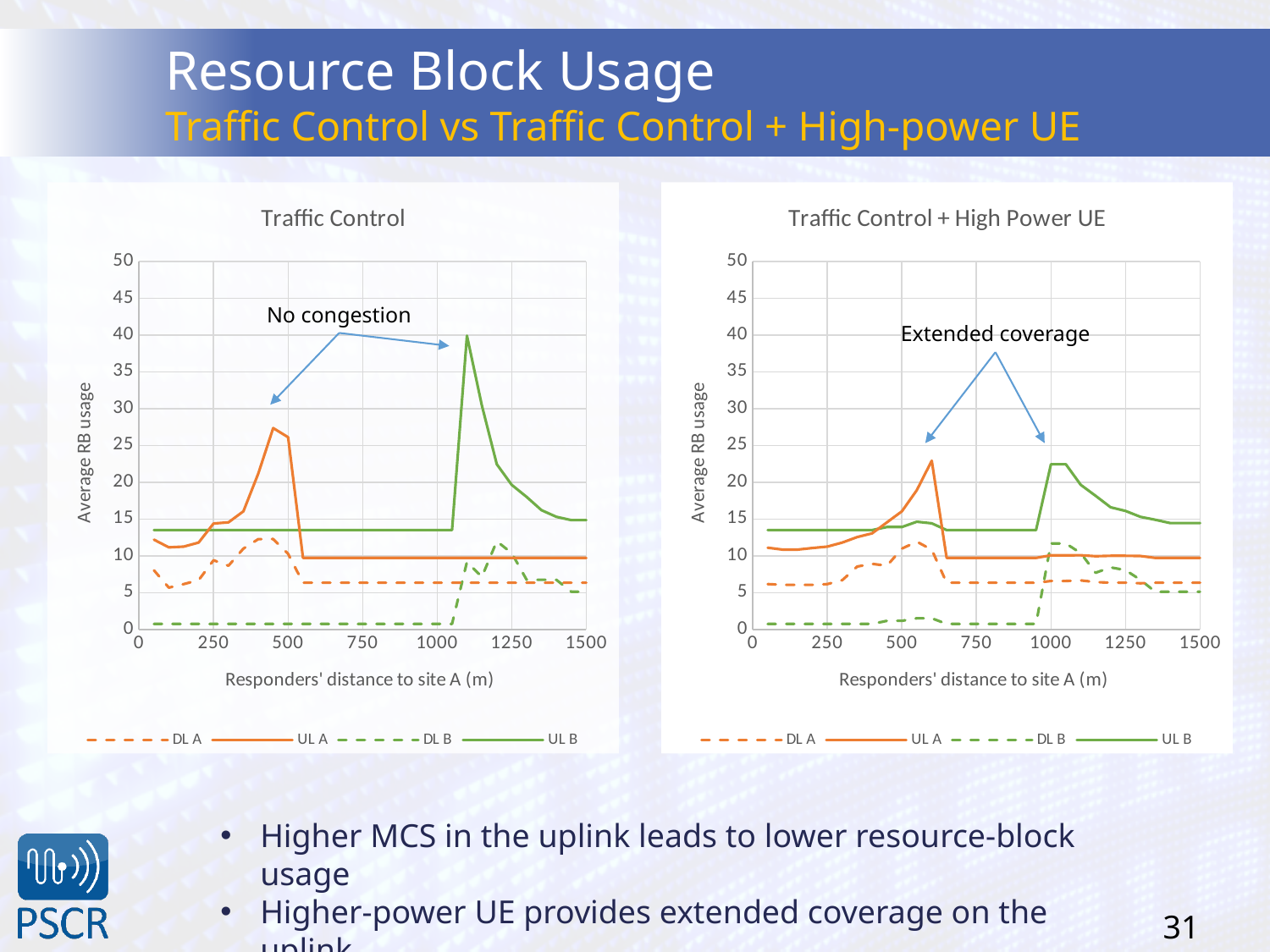
In the "Traffic Control + High Power UE" chart, is the peak value of UL B greater or less than 30? less In the "Traffic Control" chart, which series has the lowest values at distances below 250 m? DL B In the "Traffic Control" chart, is the peak value of UL B greater or less than 35? greater What type of chart is the "Traffic Control" chart on the left? line chart In the "Traffic Control + High Power UE" chart, is the peak value of UL A greater or less than 20? greater What is the maximum value shown on the y-axis of the "Traffic Control" chart? 50 In the "Traffic Control" chart, which is larger: the peak of UL B or the peak of UL A? UL B How many series does the legend of the "Traffic Control + High Power UE" chart list? 4 What is the y-axis title of the "Traffic Control + High Power UE" chart? Average RB usage In the "Traffic Control" chart, which series reaches the highest value? UL B What are the series names in the legend of the "Traffic Control" chart? DL A, UL A, DL B, UL B